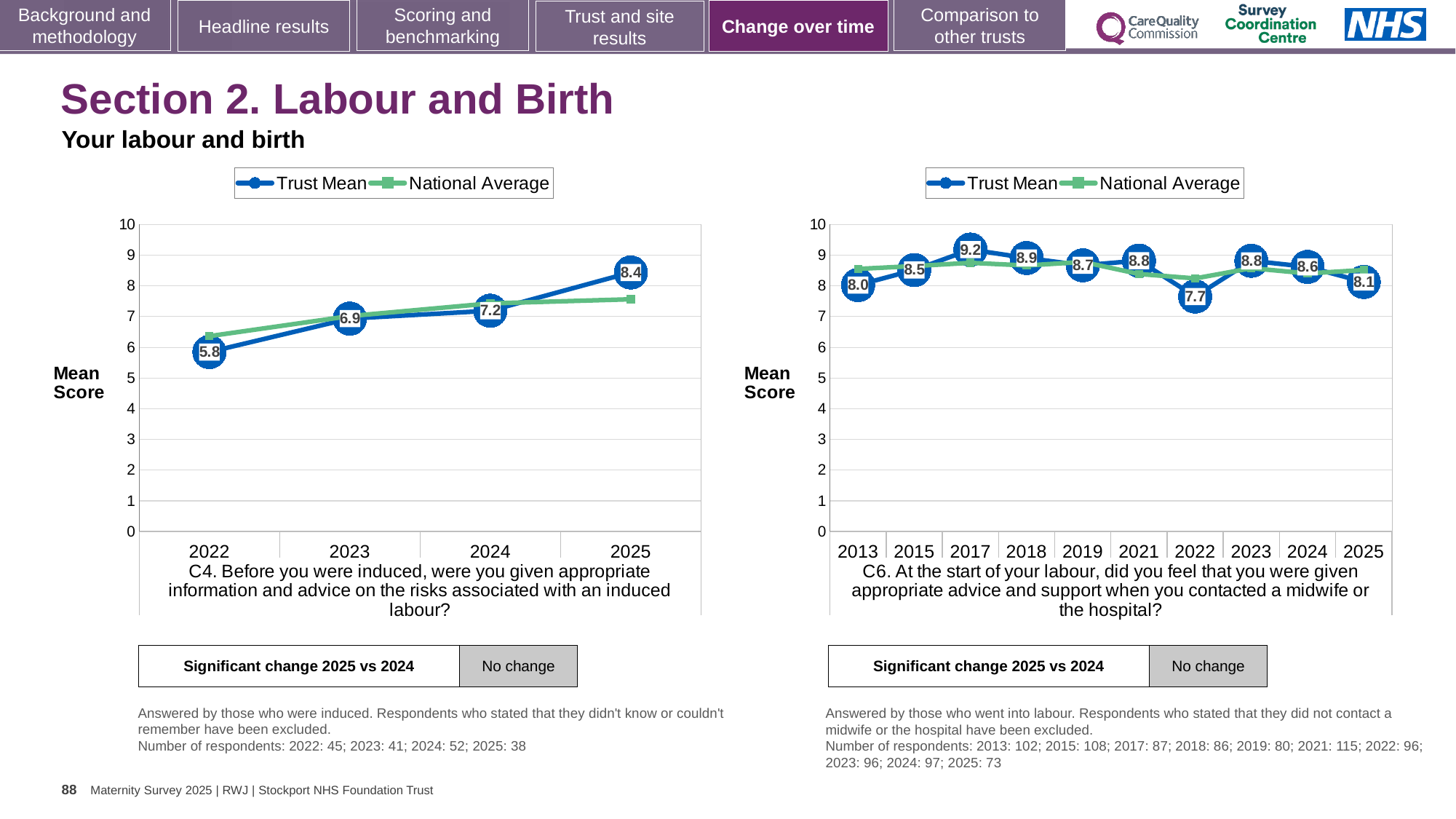
In the left chart (C4), what is the Trust Mean score for 2025? 8.4 In the left chart (C4), what is the difference between the Trust Mean scores for 2025 and 2024? 1.2 In the left chart (C4), which year has the lowest Trust Mean score? 2022 In the left chart (C4), what is the Trust Mean score for 2022? 5.8 In the right chart (C6), which is larger, the Trust Mean for 2023 or for 2025? 2023 In the left chart (C4), does the Trust Mean rise or fall from 2022 to 2025? rise In the right chart (C6), what is the Trust Mean score for 2017? 9.2 How many series does the legend of the right chart (C6) list? 2 In the left chart (C4), is the National Average value for 2022 greater or less than 7? less In the right chart (C6), which year has the lowest Trust Mean score? 2022 In the right chart (C6), how many years are shown on the x axis? 10 In the right chart (C6), which year has the highest Trust Mean score? 2017